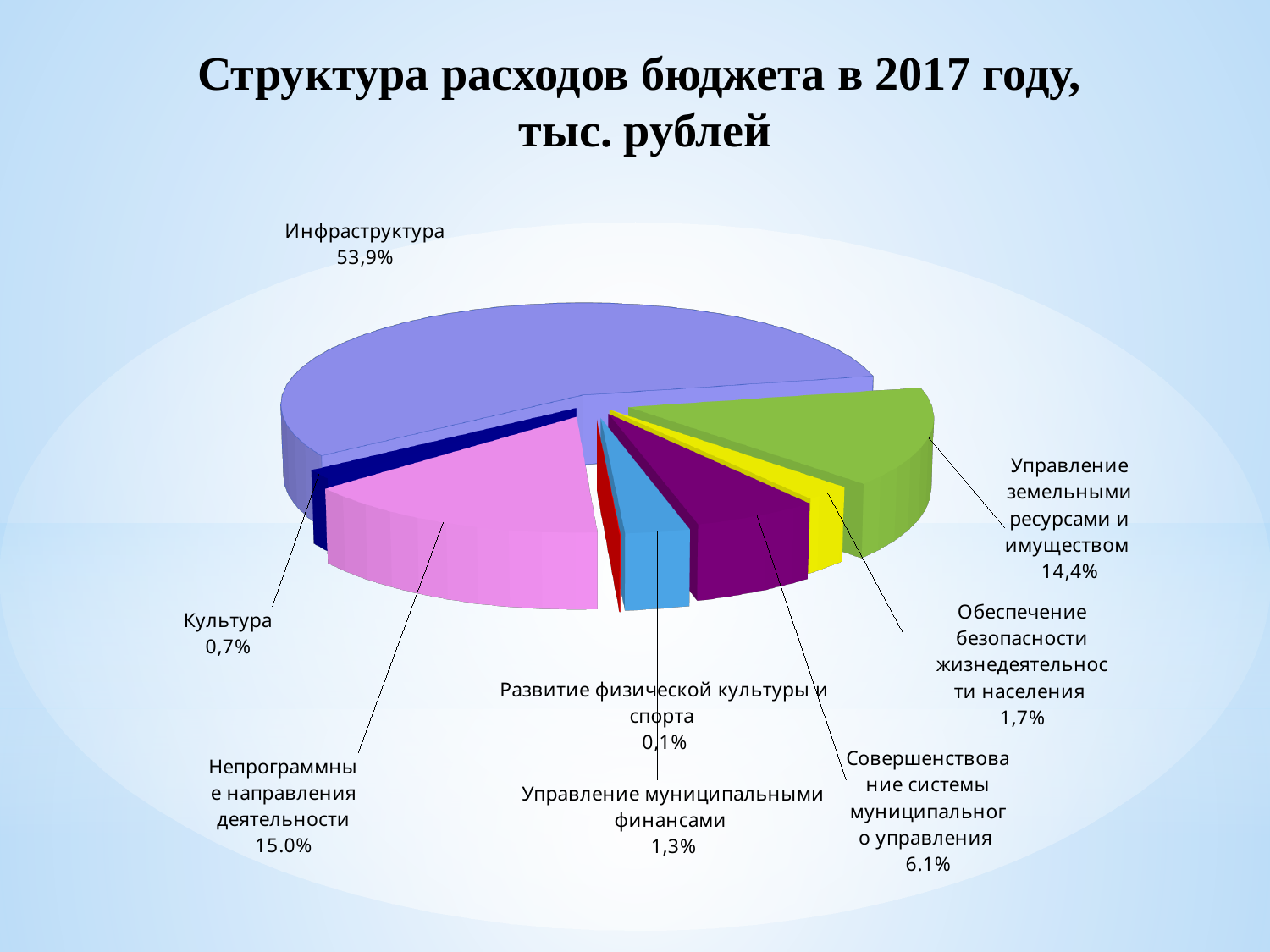
Which category has the smallest share of the pie? Развитие физической культуры и спорта What percentage is shown for Непрограммные направления деятельности? 15.0% Which category has the largest share of the pie? Инфраструктура What is the difference in percentage points between Инфраструктура and Управление земельными ресурсами и имуществом? 39,5 What is the value for Совершенствование системы муниципального управления? 6.1% What share is shown for Культура? 0,7% What share of budget expenditure does Инфраструктура account for? 53,9% What is the value for Обеспечение безопасности жизнедеятельности населения? 1,7% What is the value shown for Управление земельными ресурсами и имуществом? 14,4% What kind of chart is shown on the slide? pie chart Which is larger: Непрограммные направления деятельности or Управление муниципальными финансами? Непрограммные направления деятельности How many slices does the pie chart have? 8